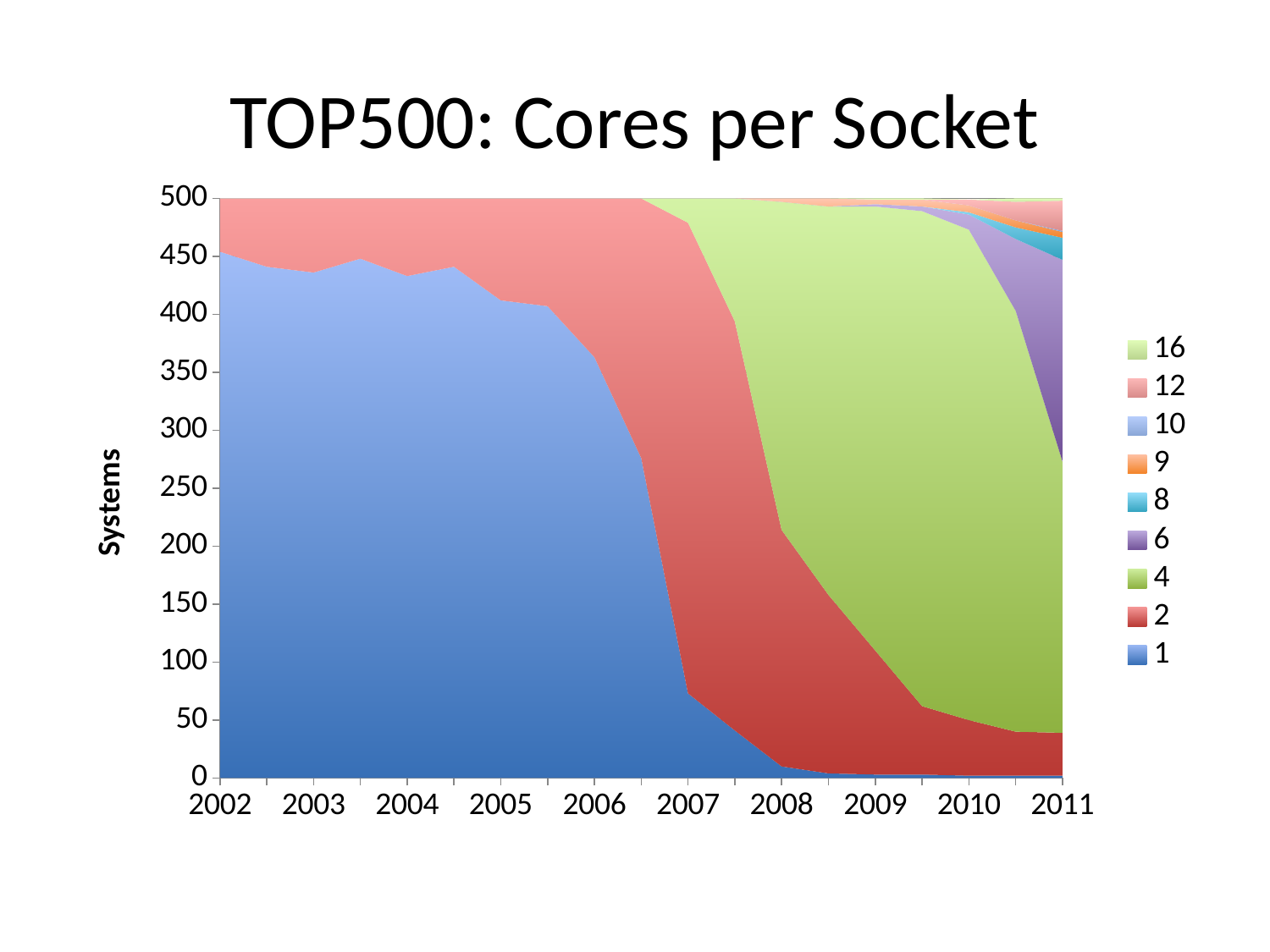
What is the label on the vertical axis? Systems Is the value for the 1-core series in 2008 greater or less than 50? less What is the maximum value shown on the vertical axis? 500 Is the value for the 1-core series in 2007 greater or less than 100? less What kind of chart is shown on the slide? Stacked area chart Is the value for the 1-core series in 2002 greater or less than 400? greater Which series is plotted at the bottom of the stack? 1 Does the number of systems with 1 core per socket rise or fall from 2002 to 2011? Fall How many years are labeled on the horizontal axis? 10 How many series does the legend list? 9